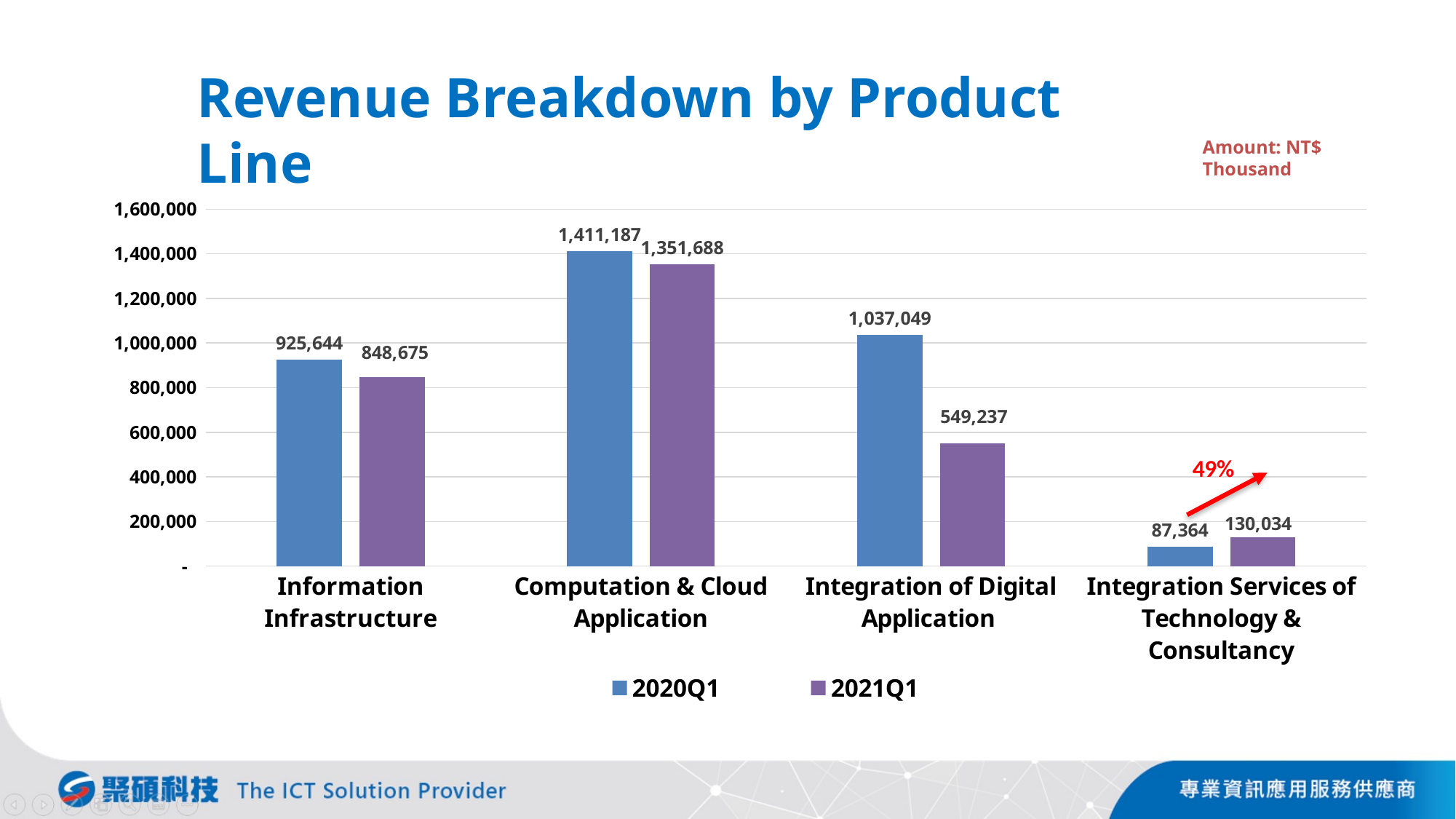
Which product line has the lowest 2021Q1 value? Integration Services of Technology & Consultancy What unit is stated for the amounts in the chart? NT$ Thousand What is the difference between the 2020Q1 and 2021Q1 values for Integration of Digital Application? 487,812 How many product line categories are shown on the x axis? 4 What is the 2020Q1 value for Information Infrastructure? 925,644 Which is larger for Integration Services of Technology & Consultancy, the 2020Q1 value or the 2021Q1 value? 2021Q1 What kind of chart is shown on the slide? Bar chart What is the 2021Q1 value for Integration Services of Technology & Consultancy? 130,034 Which product line has the highest 2020Q1 value? Computation & Cloud Application Is the 2021Q1 value for Computation & Cloud Application greater or less than 1,200,000? greater What is the 2021Q1 value for Integration of Digital Application? 549,237 How many series does the legend list? 2